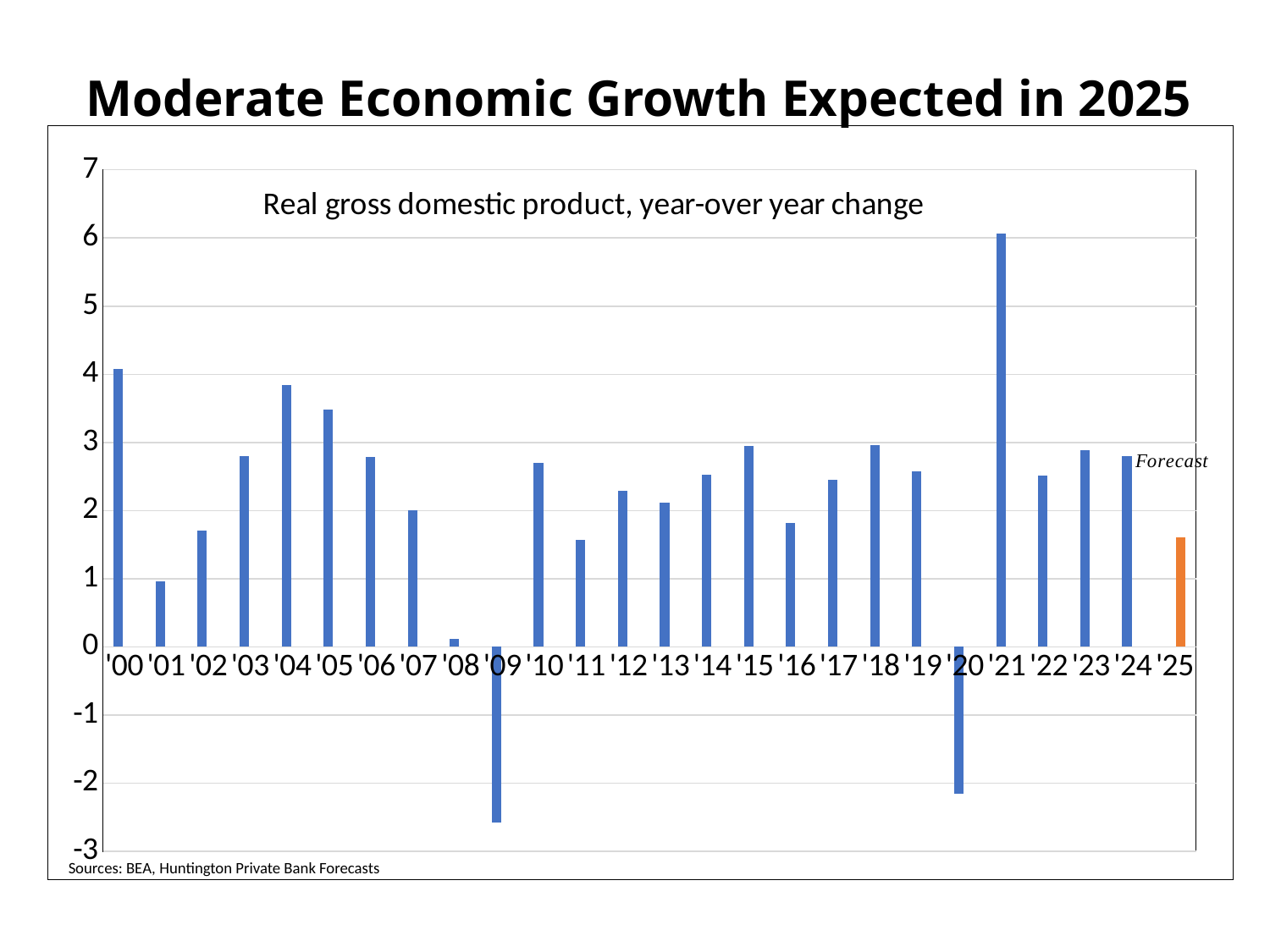
What kind of chart is shown on the slide? bar chart Which year's bar is shown in orange and labelled as a forecast? '25 How many years are plotted on the chart? 26 Which year has the larger value, '04 or '05? '04 Is the value for '08 greater or less than 1? less Which year has the highest real GDP year-over-year change? '21 Which year has the larger value, '21 or '00? '21 Is the value for '11 greater or less than 2? less Is the value for '21 greater or less than 5? greater Which year has the lowest real GDP year-over-year change? '09